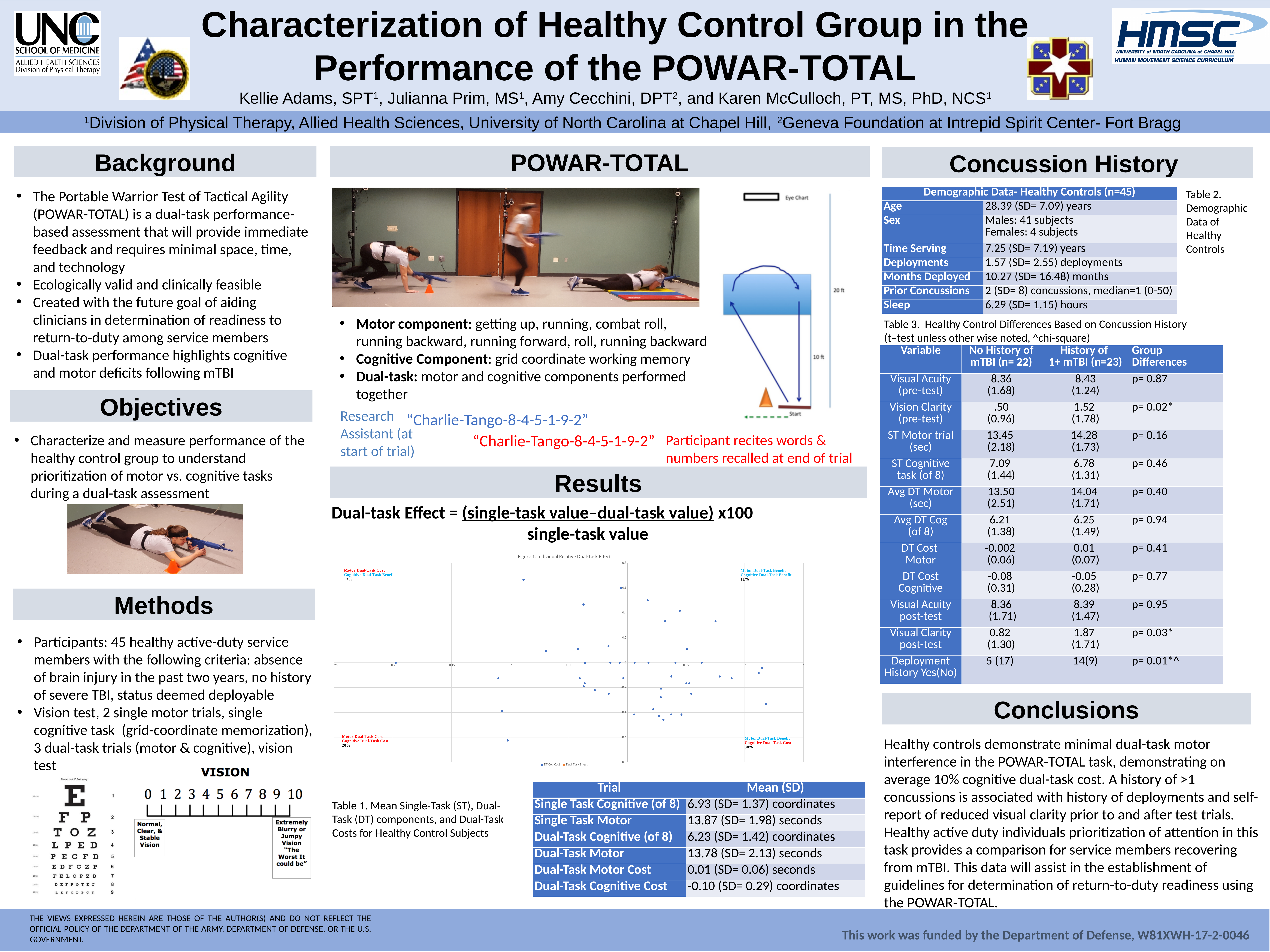
What kind of chart is Figure 1. Individual Relative Dual-Task Effect? scatter plot In Figure 1, what is the maximum value shown on the vertical axis? 0.8 What is the title of the chart in the Results section? Figure 1. Individual Relative Dual-Task Effect In Figure 1, what is the difference between the percentage in the Motor Dual-Task Benefit / Cognitive Dual-Task Cost quadrant and the Motor Dual-Task Cost / Cognitive Dual-Task Cost quadrant? 18% In Figure 1, which quadrant has the lowest percentage of participants? Motor Dual-Task Benefit, Cognitive Dual-Task Benefit In Figure 1, what percentage of participants fall in the Motor Dual-Task Cost / Cognitive Dual-Task Cost quadrant? 20% What are the two legend entries in Figure 1? DT Cog Cost and Dual Task Effect How many series does the legend of Figure 1 list? 2 In Figure 1, which quadrant has the highest percentage of participants? Motor Dual-Task Benefit, Cognitive Dual-Task Cost In Figure 1, what percentage of participants fall in the Motor Dual-Task Benefit / Cognitive Dual-Task Cost quadrant? 38% In Figure 1, what percentage of participants fall in the Motor Dual-Task Cost / Cognitive Dual-Task Benefit quadrant? 13% In Figure 1, what percentage of participants fall in the Motor Dual-Task Benefit / Cognitive Dual-Task Benefit quadrant? 11%